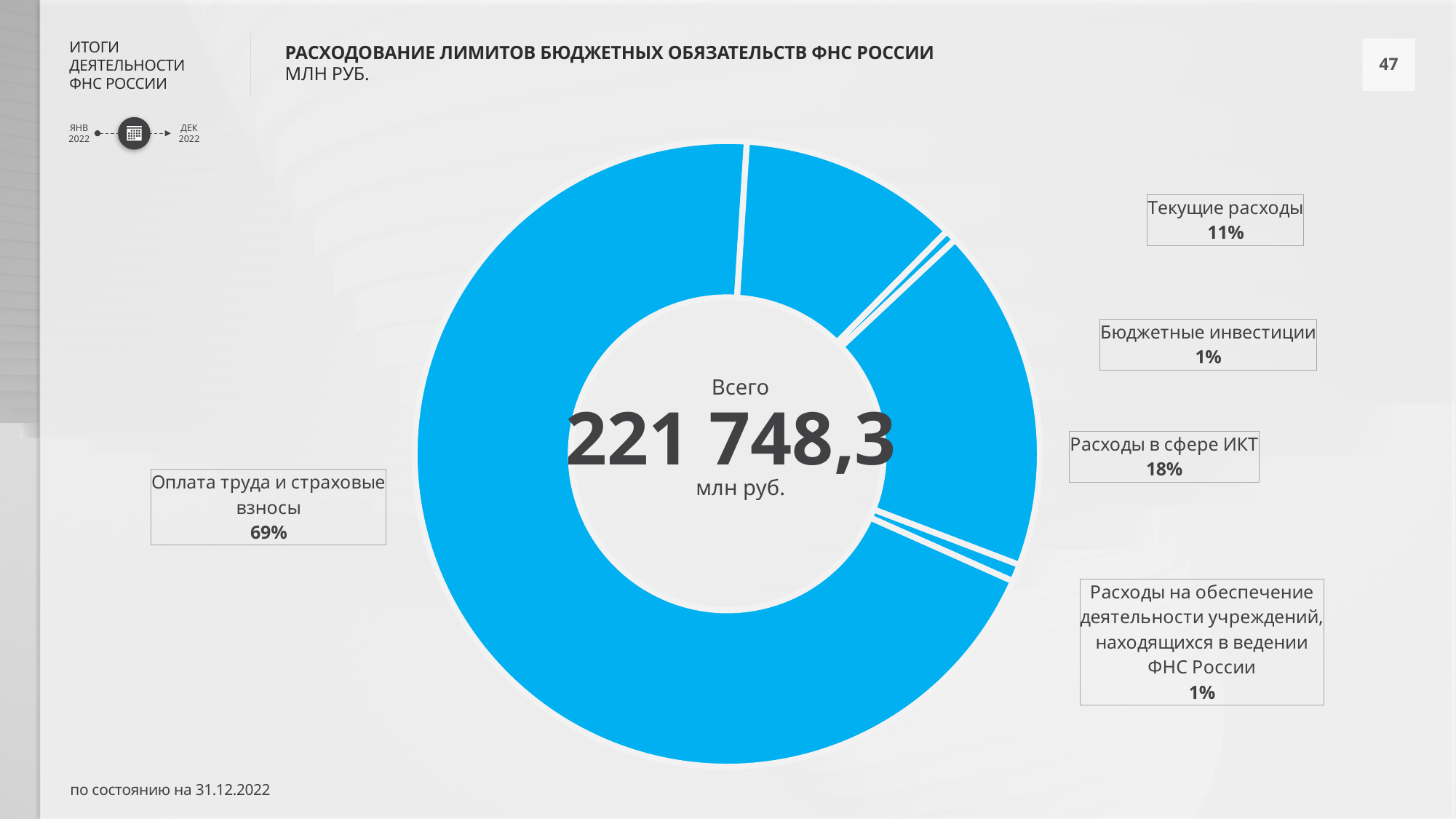
What is the combined share of "Бюджетные инвестиции" and "Расходы на обеспечение деятельности учреждений, находящихся в ведении ФНС России"? 2% What is the total value shown in the centre of the chart? 221 748,3 млн руб. What is the difference in percentage points between "Расходы в сфере ИКТ" and "Текущие расходы"? 7 percentage points What is the title of the chart? РАСХОДОВАНИЕ ЛИМИТОВ БЮДЖЕТНЫХ ОБЯЗАТЕЛЬСТВ ФНС РОССИИ Which is larger: the share for "Текущие расходы" or the share for "Расходы в сфере ИКТ"? Расходы в сфере ИКТ What share of the chart is labelled "Оплата труда и страховые взносы"? 69% Which category has the largest share of the chart? Оплата труда и страховые взносы How many categories are shown in the chart? 5 What share is shown for "Бюджетные инвестиции"? 1% What share is shown for "Текущие расходы"? 11% What type of chart is shown on the slide? Pie chart (donut)